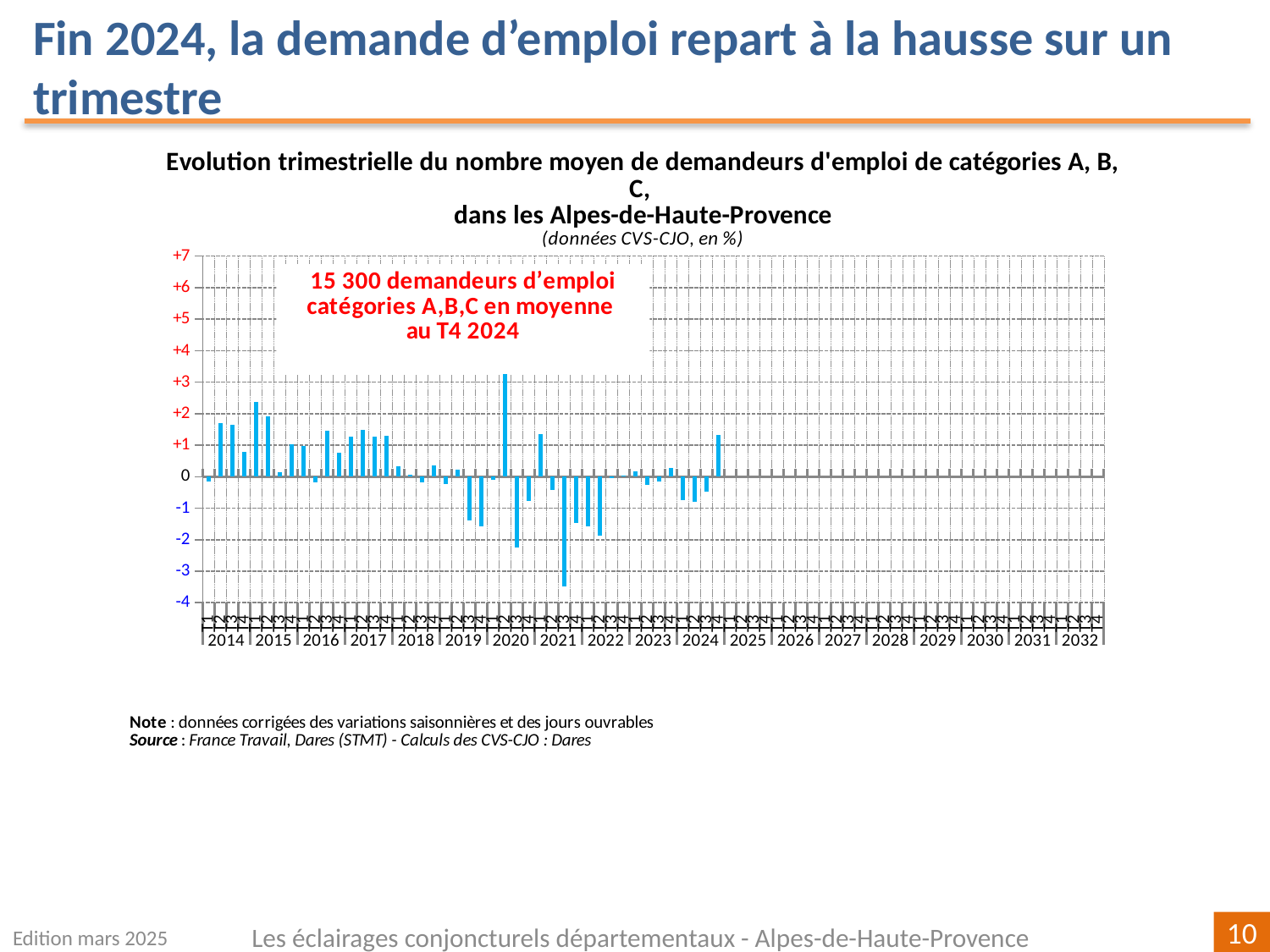
What is the first year labelled on the horizontal axis? 2014 In which year does the tallest bar on the chart occur? 2020 Is the value of the last plotted bar (end of 2024) greater or less than 0? greater Is the value of the tallest bar on the chart greater or less than +3? greater Which is larger: the tallest bar in 2020 or the tallest bar in 2015? 2020 According to the annotation on the chart, how many job seekers in categories A, B, C were there on average in T4 2024? 15 300 What kind of chart is shown on the slide? bar chart Is the lowest bar in 2019 greater or less than -1? less In which year does the lowest (most negative) bar on the chart occur? 2021 What is the highest value shown on the vertical axis? +7